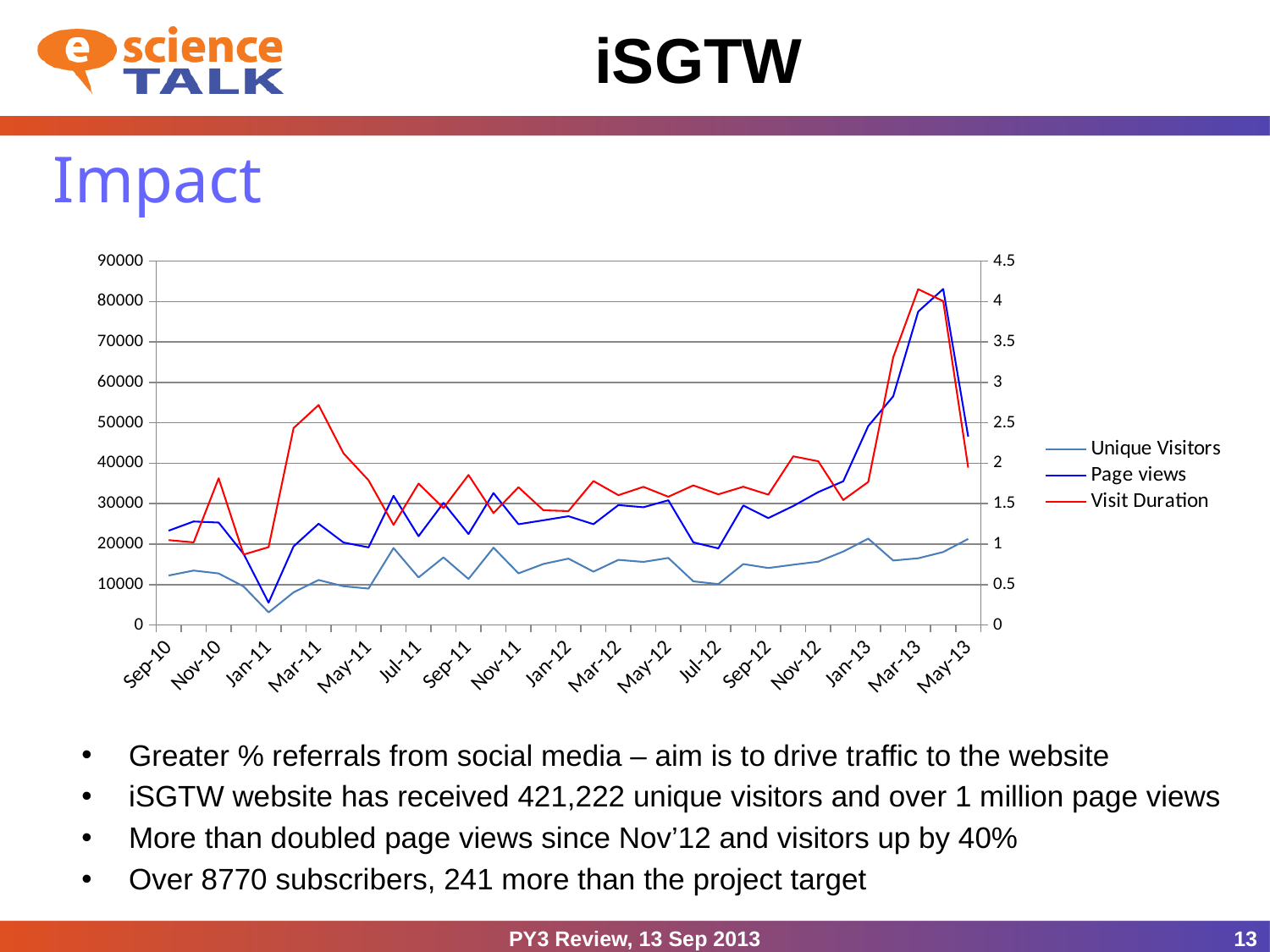
Which is larger at Mar-13: Page views or Unique Visitors? Page views What kind of chart is shown on the slide? line chart How many month labels are shown on the x axis of the chart? 17 Do Page views rise or fall between Nov-12 and Mar-13? rise Is the value for Unique Visitors at Jan-11 greater or less than 10000? less Is the value for Page views at Jan-11 greater or less than 10000? less How many series does the chart legend list? 3 At which labelled month are Page views lowest? Jan-11 Which series are listed in the chart legend? Unique Visitors, Page views, Visit Duration Is the value for Visit Duration at Mar-13 greater or less than 4? greater